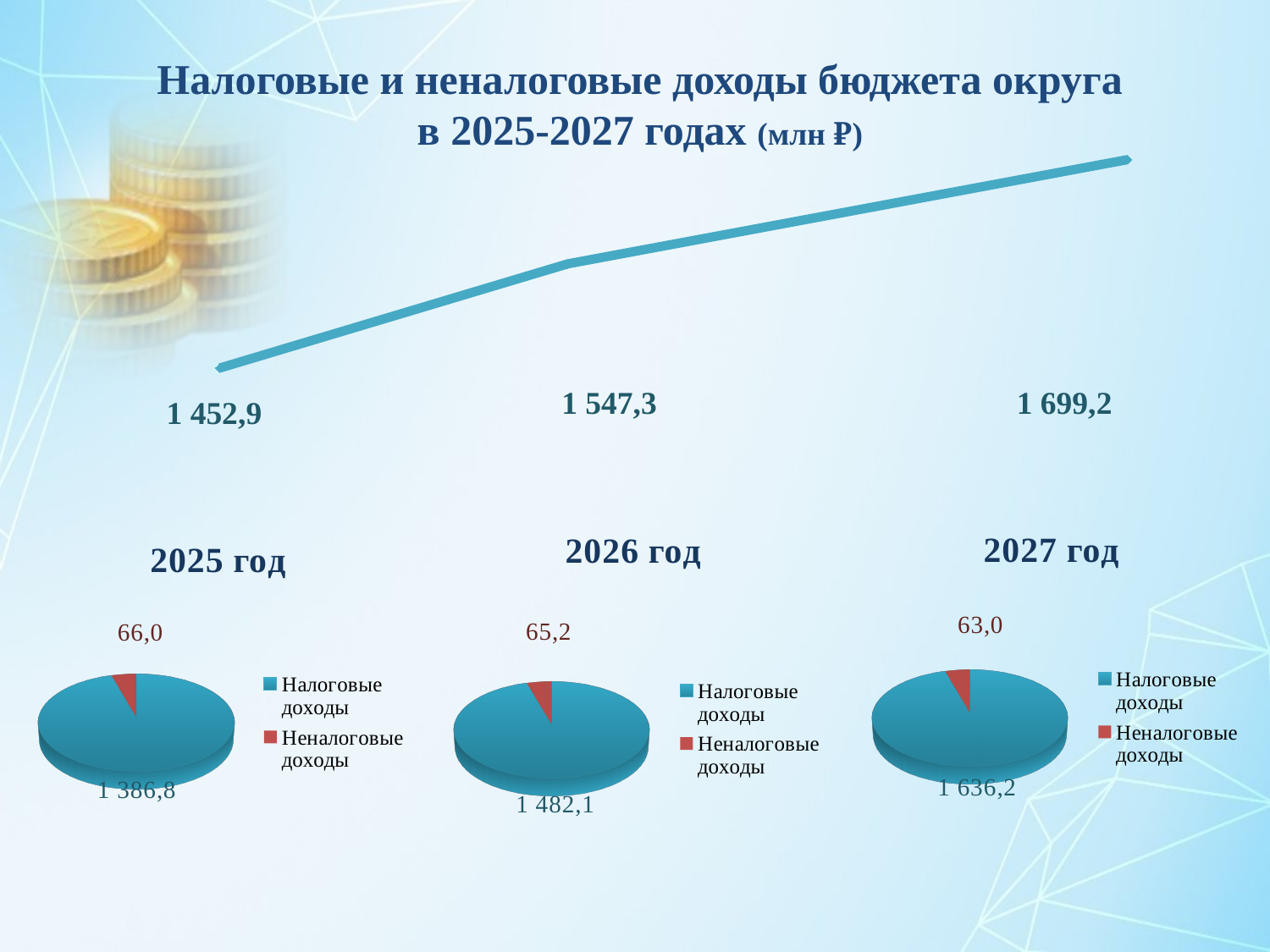
In the '2027 год' pie chart, which slice is larger, Налоговые доходы or Неналоговые доходы? Налоговые доходы In the '2027 год' pie chart, what is the value for Налоговые доходы? 1 636,2 What kind of chart is used for the '2026 год' data at the bottom of the slide? pie chart In the '2025 год' pie chart, what is the value for Налоговые доходы? 1 386,8 On the line chart at the top of the slide, what is the value for the first (2025) point? 1 452,9 On the line chart at the top of the slide, do the values rise or fall from left to right? rise On the line chart at the top of the slide, which point has the highest value? 1 699,2 (2027) On the line chart at the top of the slide, what is the difference between the 2026 value and the 2025 value? 94,4 On the line chart at the top of the slide, what is the value for the last (2027) point? 1 699,2 On the line chart at the top of the slide, how many data points are plotted? 3 In the '2026 год' pie chart, what is the value for Неналоговые доходы? 65,2 How many series does the legend of the '2025 год' pie chart list? 2